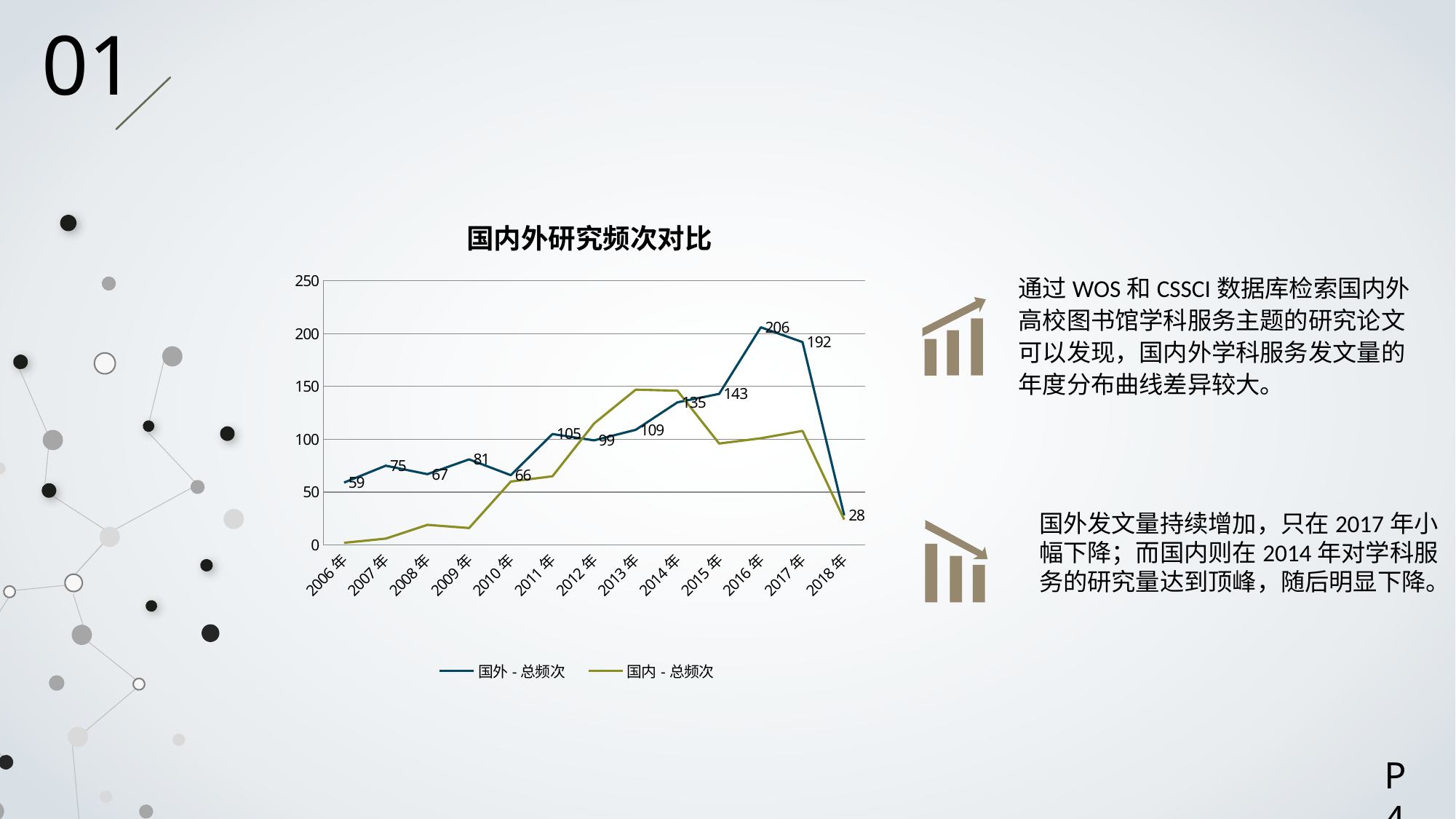
How many years are plotted along the x axis? 13 What type of chart is shown on the slide? line chart What is the value of 国外 - 总频次 in 2018 年? 28 What is the value of 国外 - 总频次 in 2016 年? 206 What is the difference between the 国外 - 总频次 values for 2016 年 and 2017 年? 14 What is the title of the chart? 国内外研究频次对比 In which year does 国外 - 总频次 reach its highest value? 2016 年 How many series does the legend list? 2 In which year is 国外 - 总频次 at its lowest? 2018 年 Is the value of 国内 - 总频次 in 2014 年 greater or less than 100? greater Which series has the larger value in 2010 年, 国外 - 总频次 or 国内 - 总频次? 国外 - 总频次 What is the value of 国外 - 总频次 in 2006 年? 59